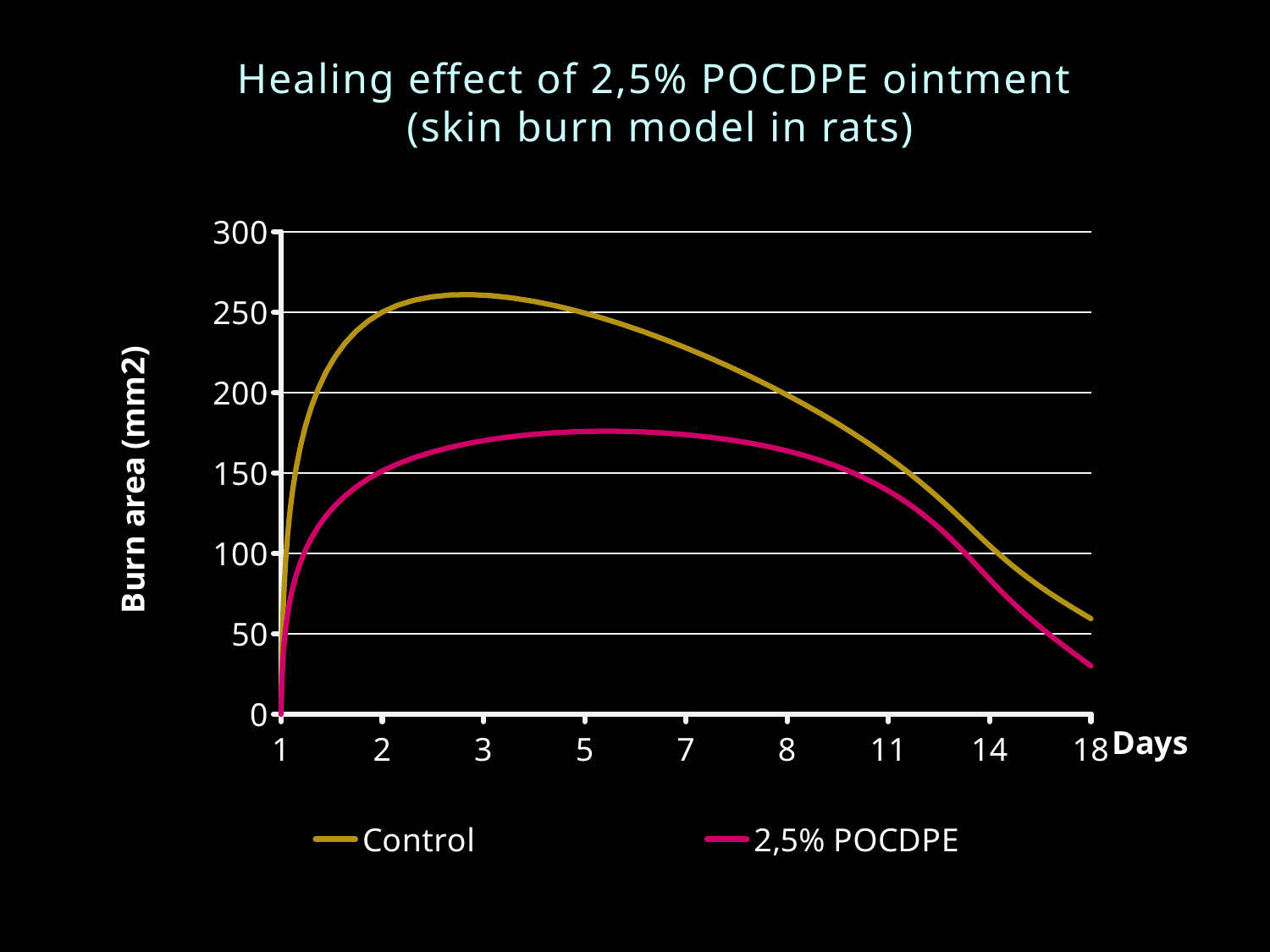
What is the title of the chart? Healing effect of 2,5% POCDPE ointment (skin burn model in rats) At day 5, which series has the larger burn area, Control or 2,5% POCDPE? Control Is the Control value at day 3 greater or less than 250? greater Does the Control burn area rise or fall from day 5 to day 18? fall How many day points are labelled on the x axis? 9 What is the label of the vertical axis? Burn area (mm2) What kind of chart is shown on the slide? line chart Is the 2,5% POCDPE value at day 18 greater or less than 50? less Is the 2,5% POCDPE value at day 5 greater or less than 200? less What is the burn area for Control at day 1? 0 How many series does the legend list? 2